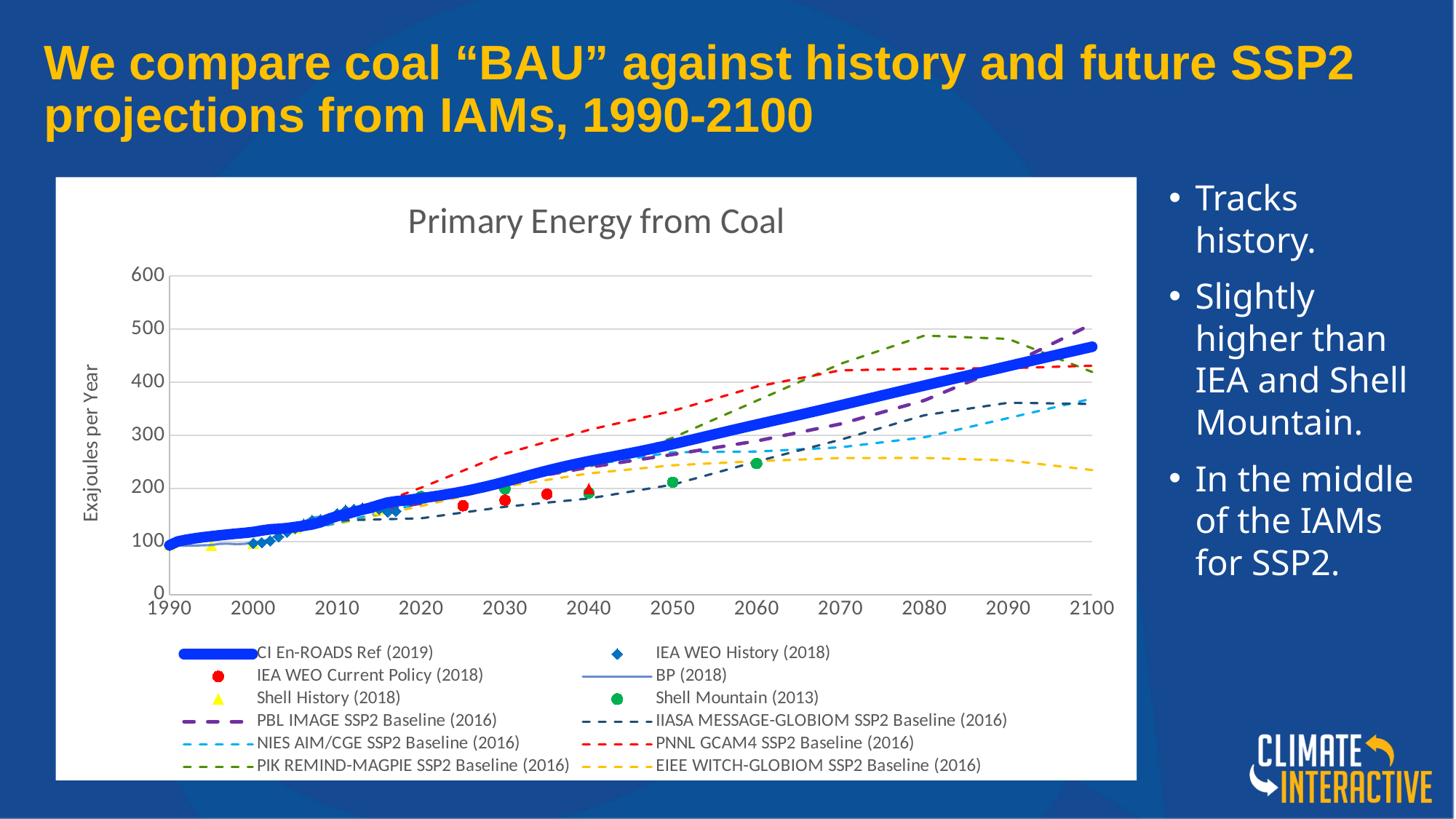
What is the title of the chart? Primary Energy from Coal What is the label on the vertical axis of the chart? Exajoules per Year Is the value of PNNL GCAM4 SSP2 Baseline (2016) in 2100 greater or less than 400? greater In 2100, which is higher: CI En-ROADS Ref (2019) or EIEE WITCH-GLOBIOM SSP2 Baseline (2016)? CI En-ROADS Ref (2019) Is the value of Shell Mountain (2013) in 2060 greater or less than 300? less In 2050, which is higher: PNNL GCAM4 SSP2 Baseline (2016) or IIASA MESSAGE-GLOBIOM SSP2 Baseline (2016)? PNNL GCAM4 SSP2 Baseline (2016) Which series has the lowest value in 2100? EIEE WITCH-GLOBIOM SSP2 Baseline (2016) What kind of chart is shown on the slide? line chart How many series does the legend of the chart list? 12 Is the value of CI En-ROADS Ref (2019) in 2100 greater or less than 400? greater Does the CI En-ROADS Ref (2019) line rise or fall from 1990 to 2100? rise